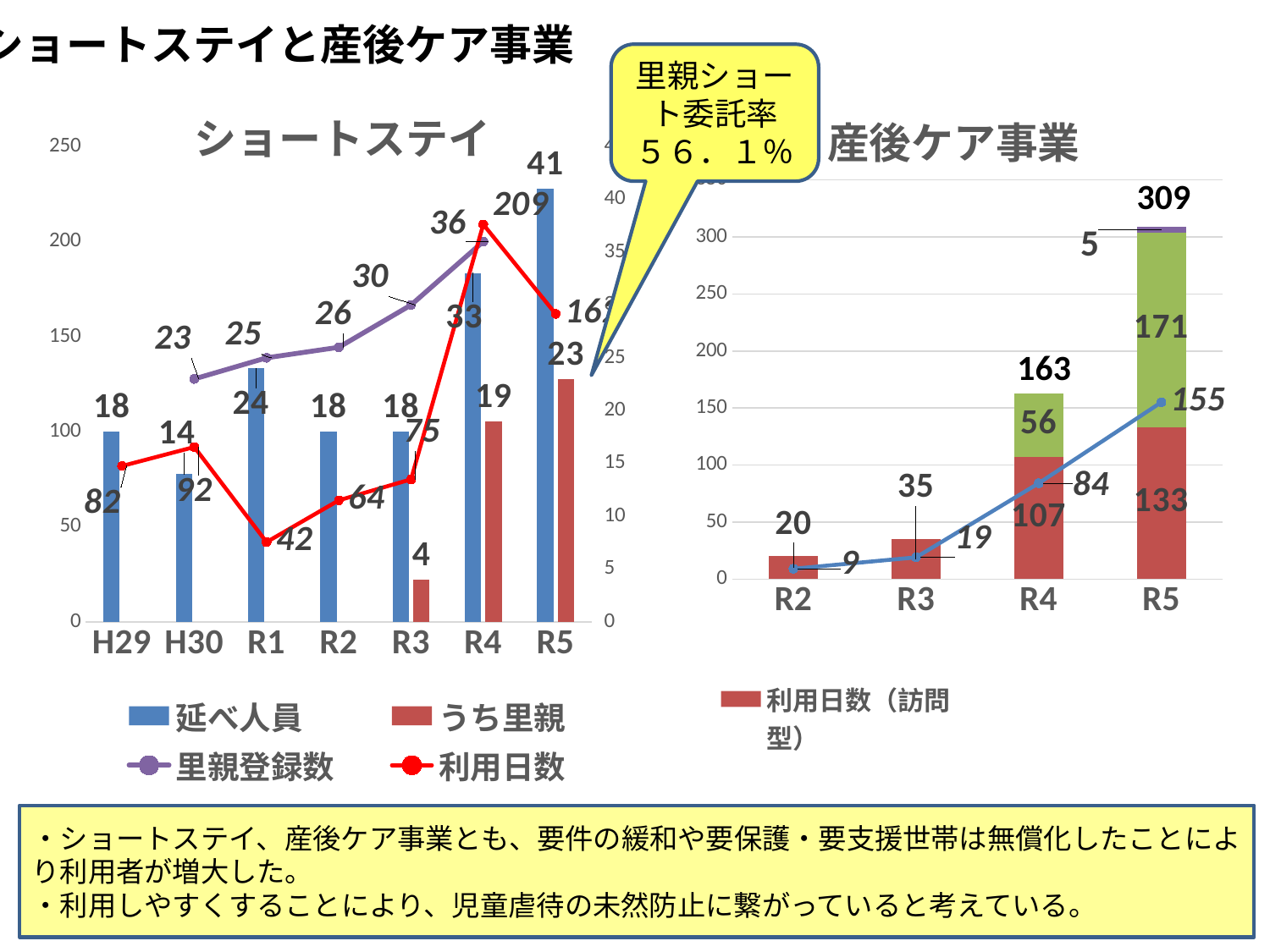
In the ショートステイ chart, what is the 延べ人員 value for R5? 41 In the 産後ケア事業 chart, what is the 利用日数（訪問型） value for R4? 107 In the ショートステイ chart, what is the 里親登録数 value for R3? 30 In the ショートステイ chart, which category has the lowest 延べ人員 value? H30 What 里親ショート委託率 is shown in the callout on the slide? 56.1% How many categories are shown on the x axis of the ショートステイ chart? 7 In the ショートステイ chart, what is the 利用日数 value for R4? 209 In the ショートステイ chart, which category has the highest 延べ人員 value? R5 In the 産後ケア事業 chart, what is the difference between the stacked bar totals for R5 and R4? 146 How many series does the legend of the ショートステイ chart list? 4 In the ショートステイ chart, what is the difference between the うち里親 values for R5 and R4? 4 In the 産後ケア事業 chart, what is the total of the stacked bar for R5? 309